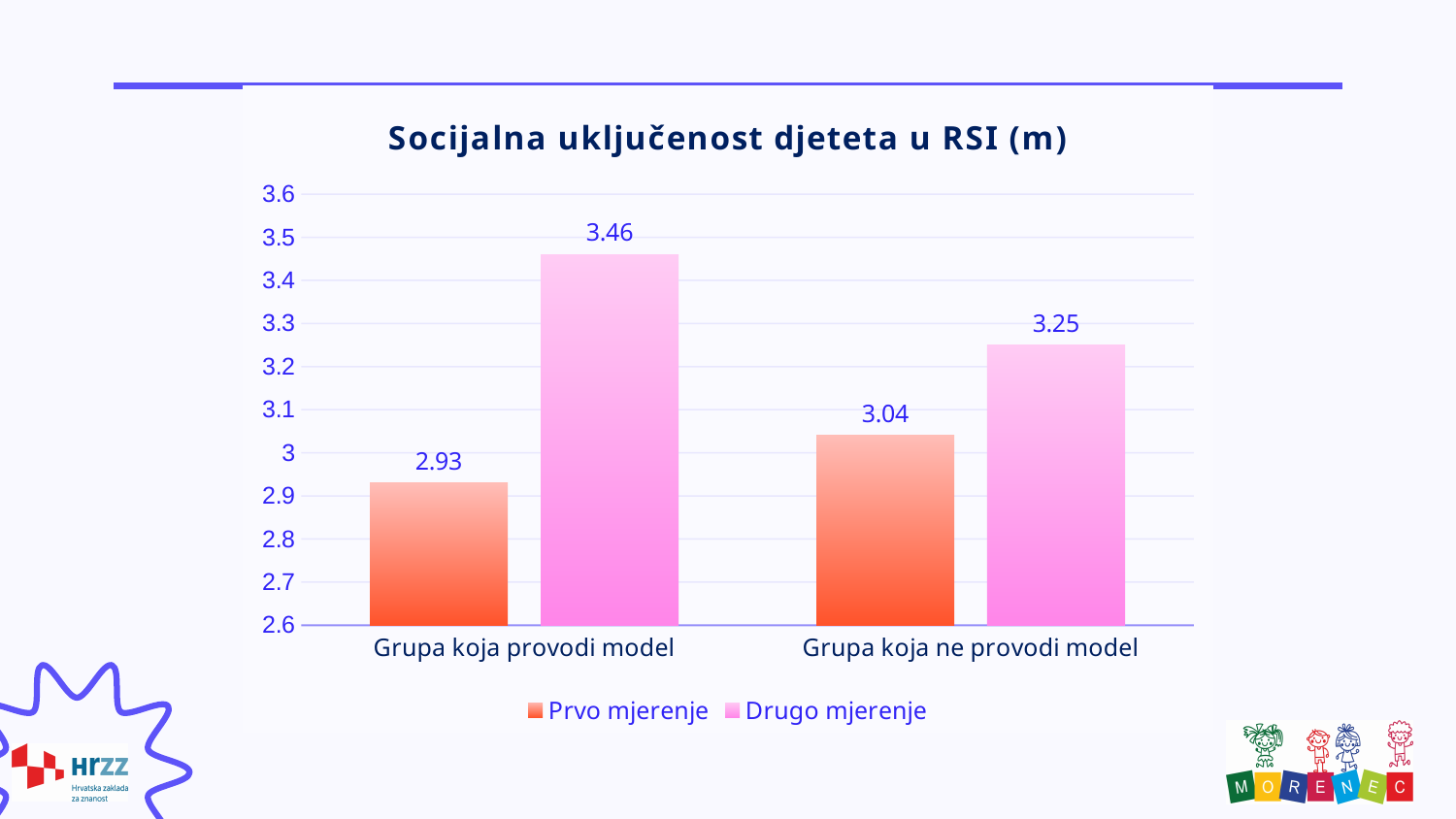
What is the difference between Drugo mjerenje and Prvo mjerenje for Grupa koja ne provodi model? 0.21 Which bar has the lowest value in the chart? Prvo mjerenje for Grupa koja provodi model What is the value of Drugo mjerenje for Grupa koja provodi model? 3.46 How many series does the legend list? 2 What is the title of the chart? Socijalna uključenost djeteta u RSI (m) Which bar has the highest value in the chart? Drugo mjerenje for Grupa koja provodi model What is the difference between Drugo mjerenje and Prvo mjerenje for Grupa koja provodi model? 0.53 What is the value of Prvo mjerenje for Grupa koja provodi model? 2.93 Which is larger: Prvo mjerenje for Grupa koja provodi model or Prvo mjerenje for Grupa koja ne provodi model? Grupa koja ne provodi model What kind of chart is shown on the slide? Bar chart What is the value of Drugo mjerenje for Grupa koja ne provodi model? 3.25 What is the value of Prvo mjerenje for Grupa koja ne provodi model? 3.04